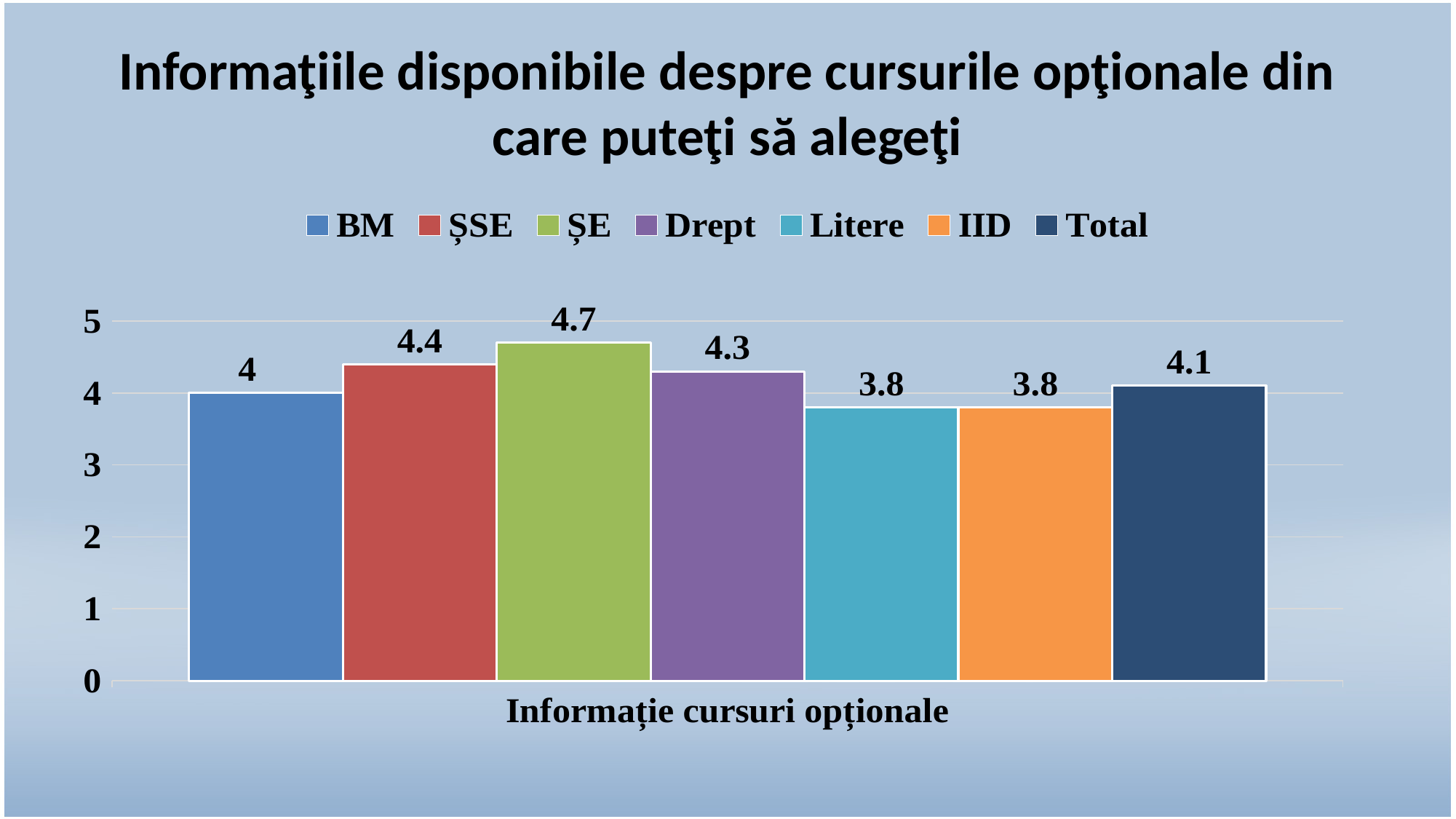
What is the value for ȘE? 4.7 What is the difference between the values for ȘE and BM? 0.7 What kind of chart is shown on the slide? bar chart What is the label on the x axis of the chart? Informație cursuri opționale Is the value for Litere greater or less than 4? less What is the value for Total? 4.1 What is the value for Drept? 4.3 How many series does the legend list? 7 Which is larger, the value for ȘSE or the value for Drept? ȘSE What is the difference between the values for ȘSE and Total? 0.3 Which series has the highest value? ȘE What is the value for BM? 4